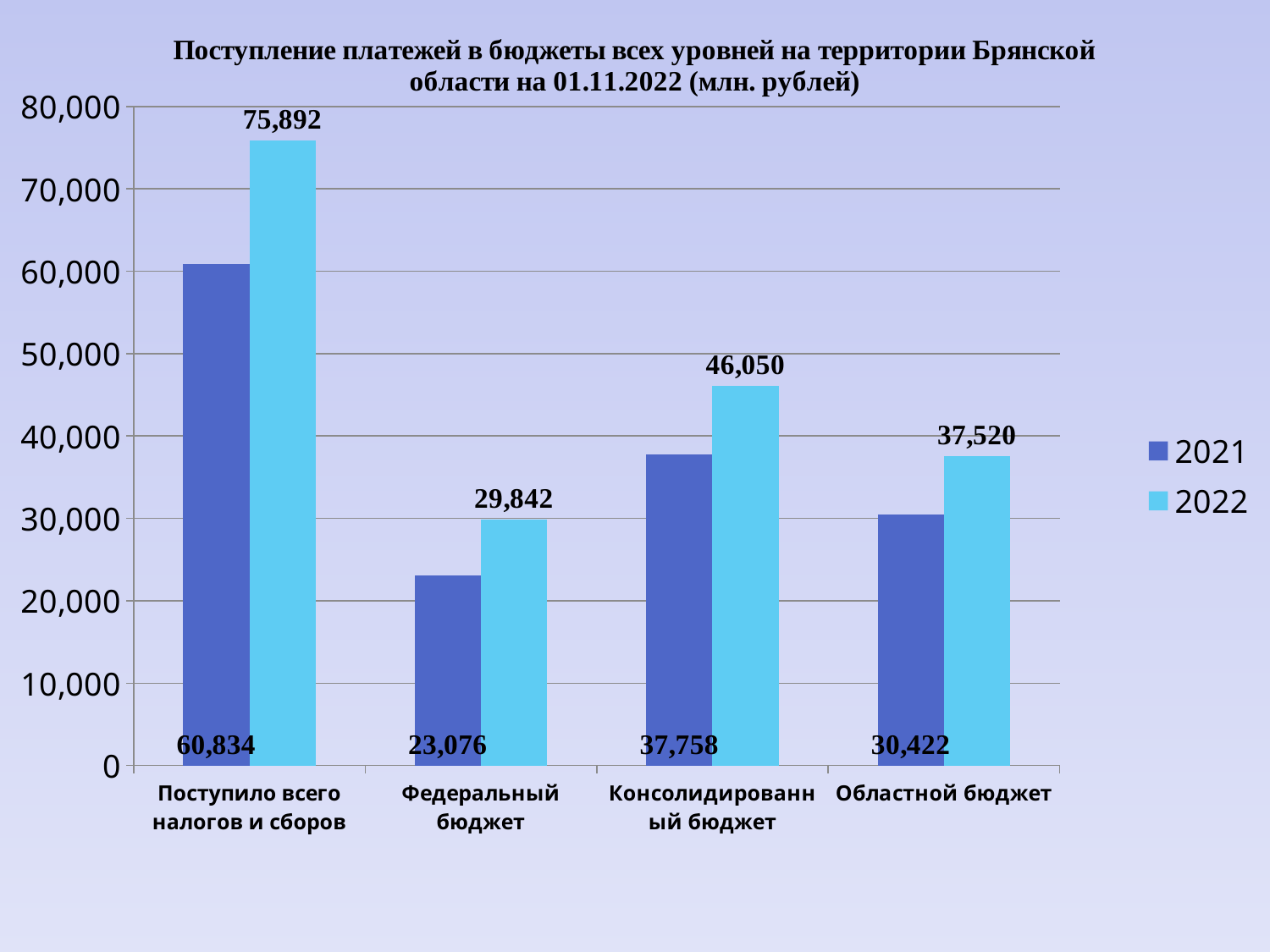
What is the difference between the 2022 and 2021 values for Областной бюджет? 7,098 Which category has the highest 2022 value? Поступило всего налогов и сборов What is the 2021 value for Областной бюджет? 30,422 What is the difference between the 2022 and 2021 values for Поступило всего налогов и сборов? 15,058 What kind of chart is shown on the slide? Bar chart Which is larger: the 2021 value for Консолидированный бюджет or the 2022 value for Федеральный бюджет? 2021 value for Консолидированный бюджет What is the 2022 value for Консолидированный бюджет? 46,050 What is the 2022 value for Поступило всего налогов и сборов? 75,892 How many series does the legend list? 2 What is the 2021 value for Федеральный бюджет? 23,076 Which category has the lowest 2021 value? Федеральный бюджет How many categories are shown on the x axis? 4